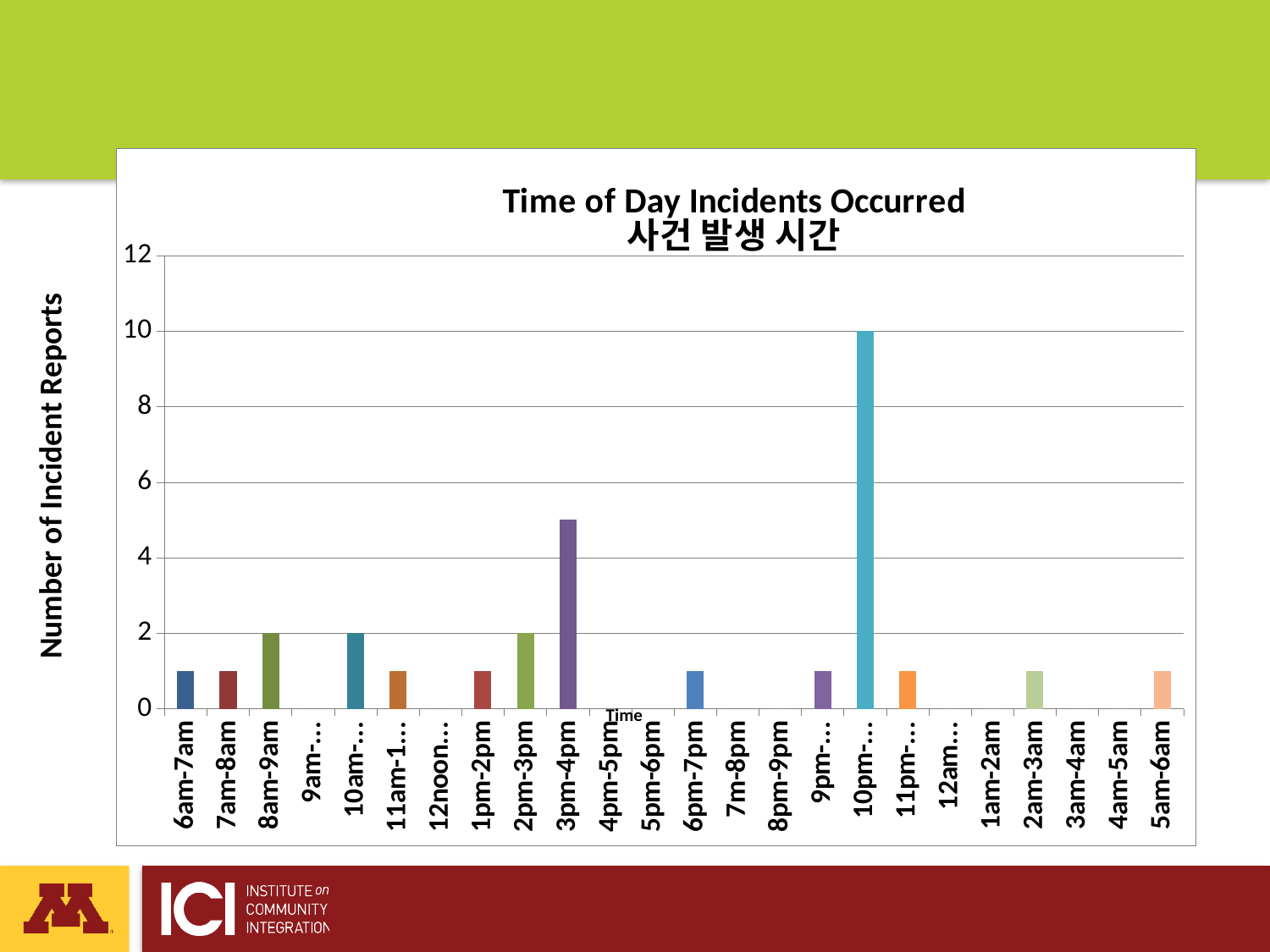
How many incident reports are shown for the 10pm-… time period? 10 Which has more incident reports, 3pm-4pm or 8am-9am? 3pm-4pm What is the label on the vertical axis of the chart? Number of Incident Reports How many incident reports are shown for 8am-9am? 2 How many incident reports are shown for 2pm-3pm? 2 What kind of chart is shown on the slide? bar chart What is the title of the chart? Time of Day Incidents Occurred 사건 발생 시간 What is the difference between the number of incident reports for 10pm-… and for 8am-9am? 8 Which time period has the highest number of incident reports? 10pm-… Is the value for 3pm-4pm greater or less than 4? greater How many time-period categories are shown on the x axis? 24 Is the value for 6am-7am greater or less than 2? less